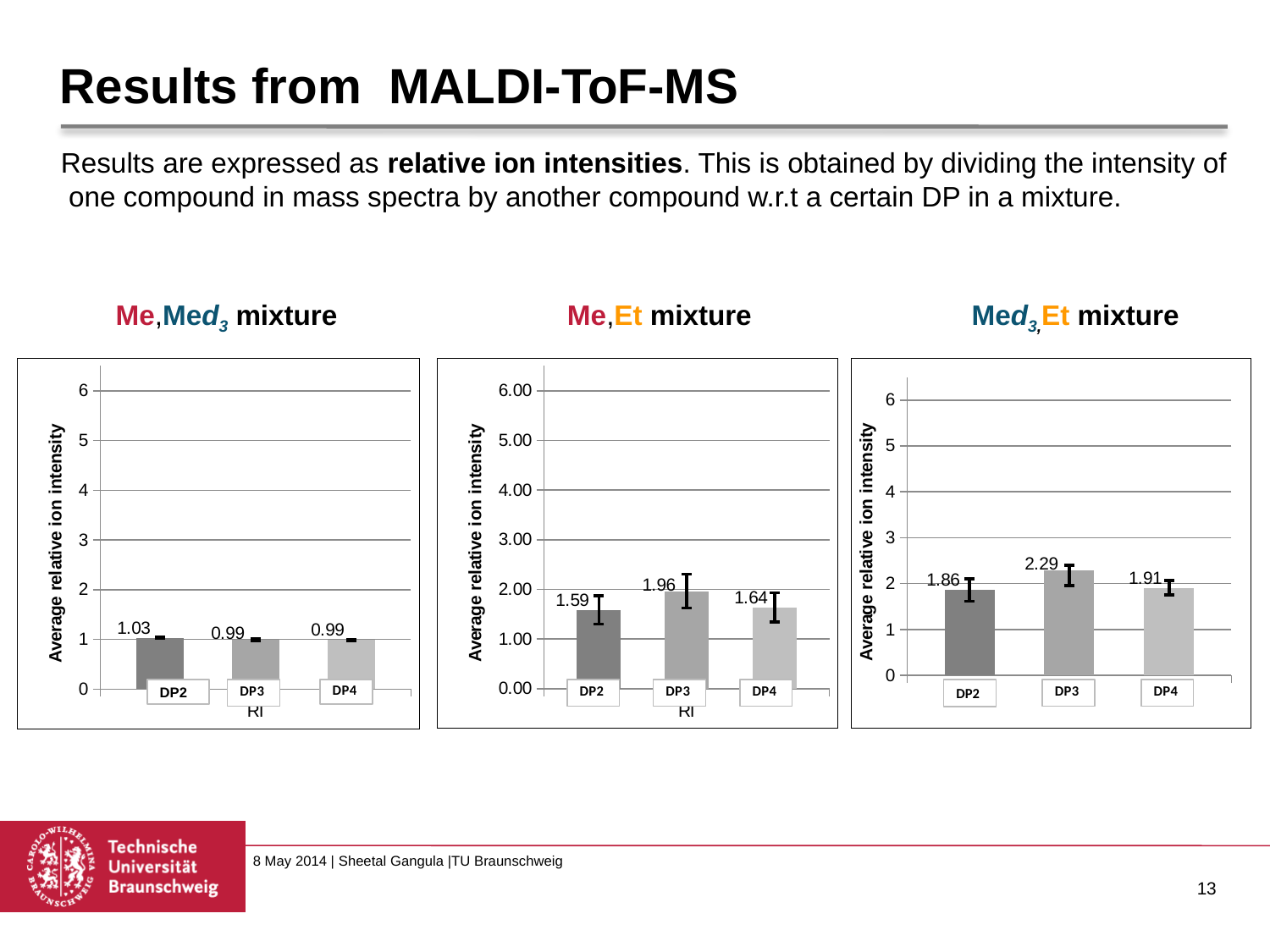
In the Med3,Et mixture chart, which is larger, the value for DP2 or DP4? DP4 What is the y-axis label of the Me,Et mixture chart? Average relative ion intensity In the Me,Et mixture chart, what is the difference between the values for DP3 and DP2? 0.37 What kind of chart is the Med3,Et mixture chart? bar chart In the Me,Et mixture chart, what is the average relative ion intensity for DP3? 1.96 In the Me,Et mixture chart, which DP has the lowest average relative ion intensity? DP2 In the Me,Et mixture chart, is the value for DP3 greater or less than 3.00? less How many DP categories are shown in the Me,Med3 mixture chart? 3 In the Me,Med3 mixture chart, what is the value for DP2? 1.03 In the Med3,Et mixture chart, what is the average relative ion intensity for DP2? 1.86 In the Med3,Et mixture chart, what is the difference between the values for DP3 and DP4? 0.38 In the Med3,Et mixture chart, which DP has the highest average relative ion intensity? DP3